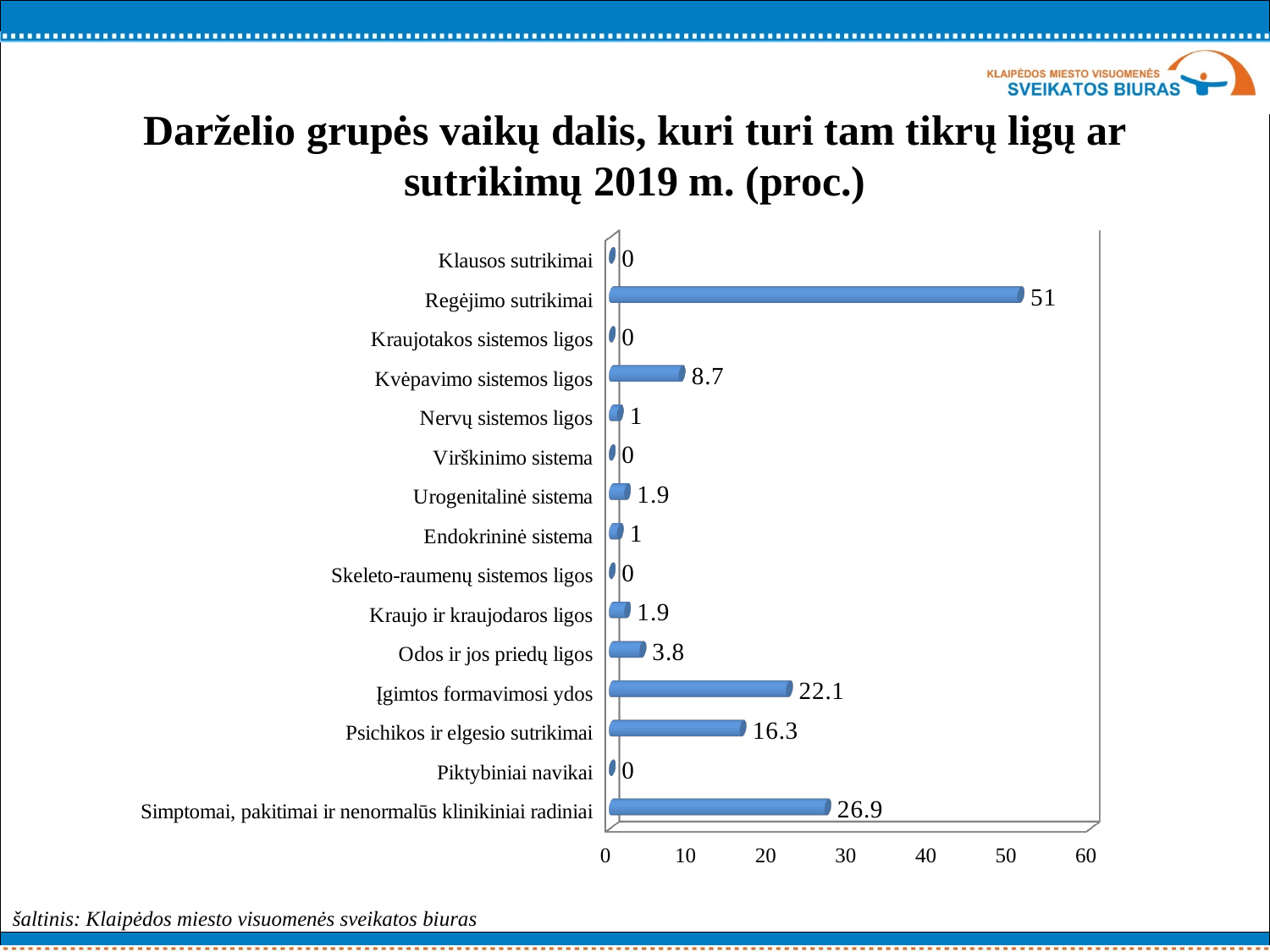
What is the value for Regėjimo sutrikimai? 51 What kind of chart is shown on the slide? bar chart Is the value for Regėjimo sutrikimai greater or less than 40? greater What is the maximum value shown on the horizontal axis? 60 What is the difference between the values for Regėjimo sutrikimai and Simptomai, pakitimai ir nenormalūs klinikiniai radiniai? 24.1 Which is larger, the value for Įgimtos formavimosi ydos or the value for Psichikos ir elgesio sutrikimai? Įgimtos formavimosi ydos Which category has the highest value? Regėjimo sutrikimai What is the value for Kvėpavimo sistemos ligos? 8.7 How many categories are shown on the chart? 15 What is the value for Psichikos ir elgesio sutrikimai? 16.3 What is the value for Simptomai, pakitimai ir nenormalūs klinikiniai radiniai? 26.9 How many categories have a value of 0? 5